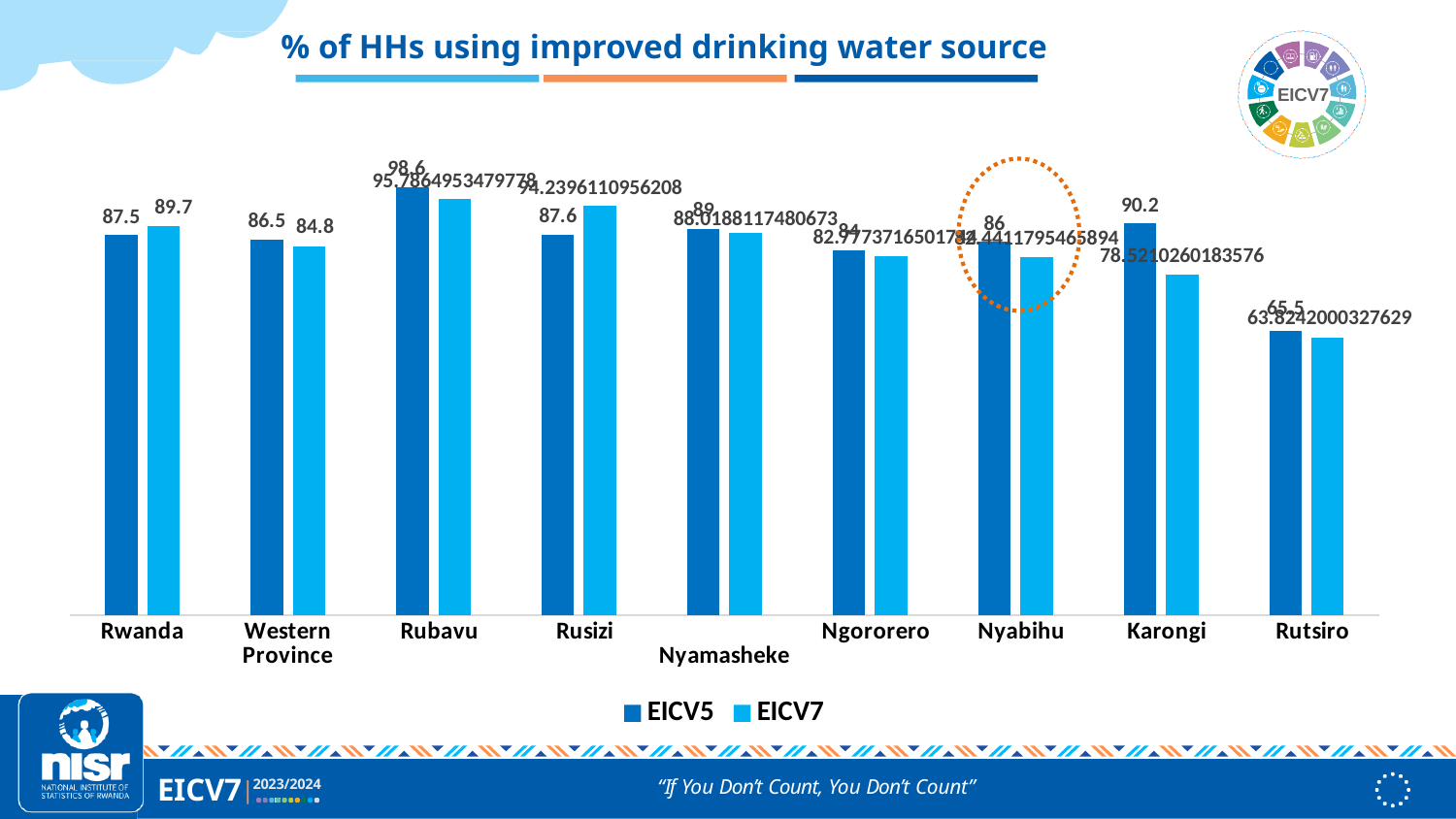
How many series does the legend list? 2 What is the EICV5 value for Rutsiro? 65.5 Which district has the highest EICV5 value? Rubavu What is the EICV5 value for Rwanda? 87.5 What is the EICV7 value for Rwanda? 89.7 What is the difference between the EICV7 and EICV5 values for Rwanda? 2.2 What type of chart is shown on the slide? Bar chart For Karongi, which is larger: the EICV5 value or the EICV7 value? EICV5 Which district has the lowest EICV7 value? Rutsiro What is the EICV5 value for Karongi? 90.2 How many categories are shown on the x axis? 9 What is the EICV7 value for Western Province? 84.8